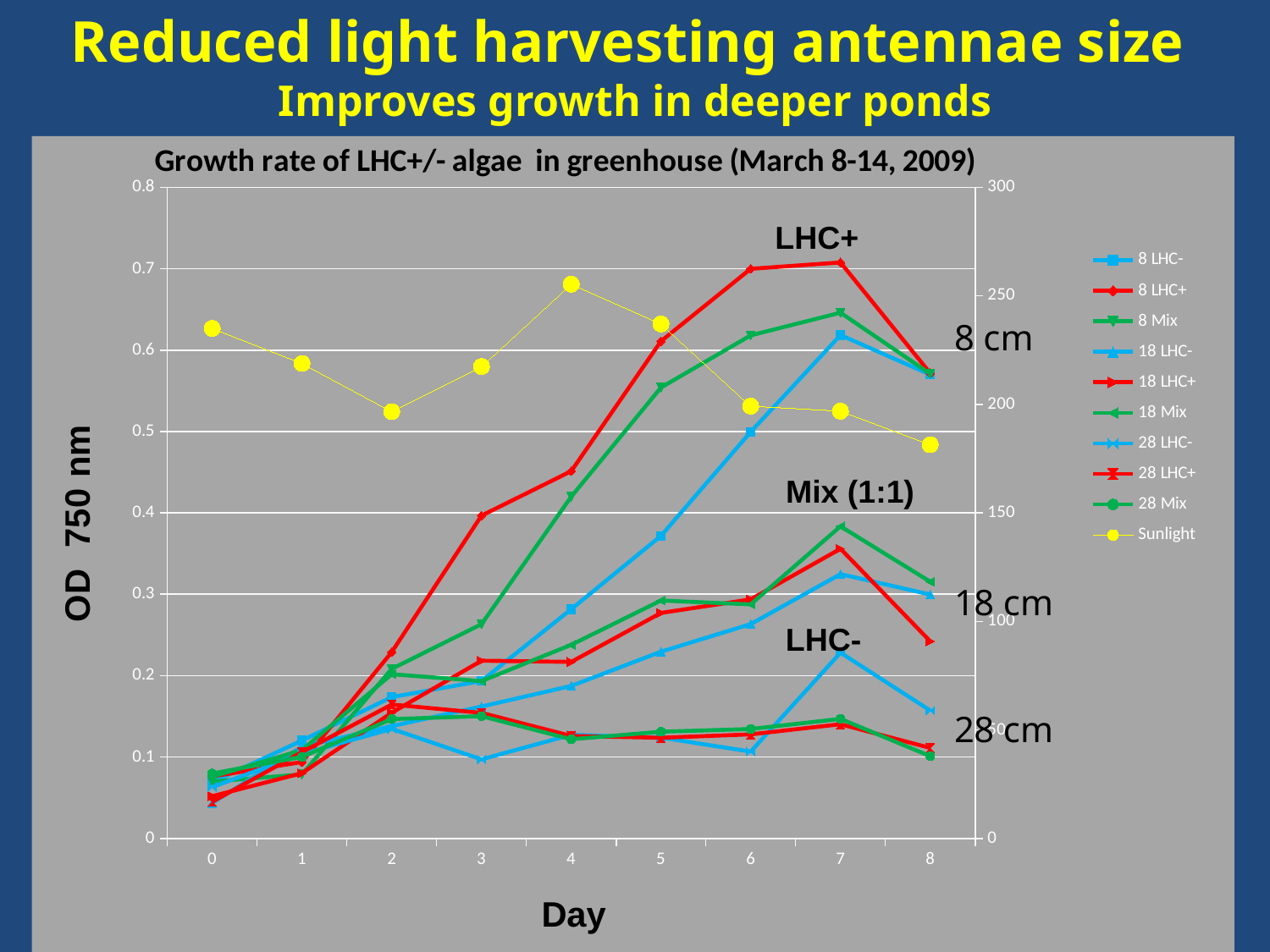
Among the algae series, which reaches the highest OD value on the chart? 8 LHC+ Is the value for 28 Mix at day 8 greater or less than 0.2? less What kind of chart is shown on the slide? line chart Does the 8 LHC+ series rise or fall from day 0 to day 7? rise At day 7, which is higher: 8 LHC+ or 8 LHC-? 8 LHC+ Is the Sunlight value at day 2 greater or less than 250 on the right axis? less How many series does the legend list? 10 How many day values are marked along the x axis? 9 What is the title of the chart? Growth rate of LHC+/- algae in greenhouse (March 8-14, 2009) Is the value for 8 LHC+ at day 6 greater or less than 0.6? greater What is the label on the left vertical axis? OD 750 nm